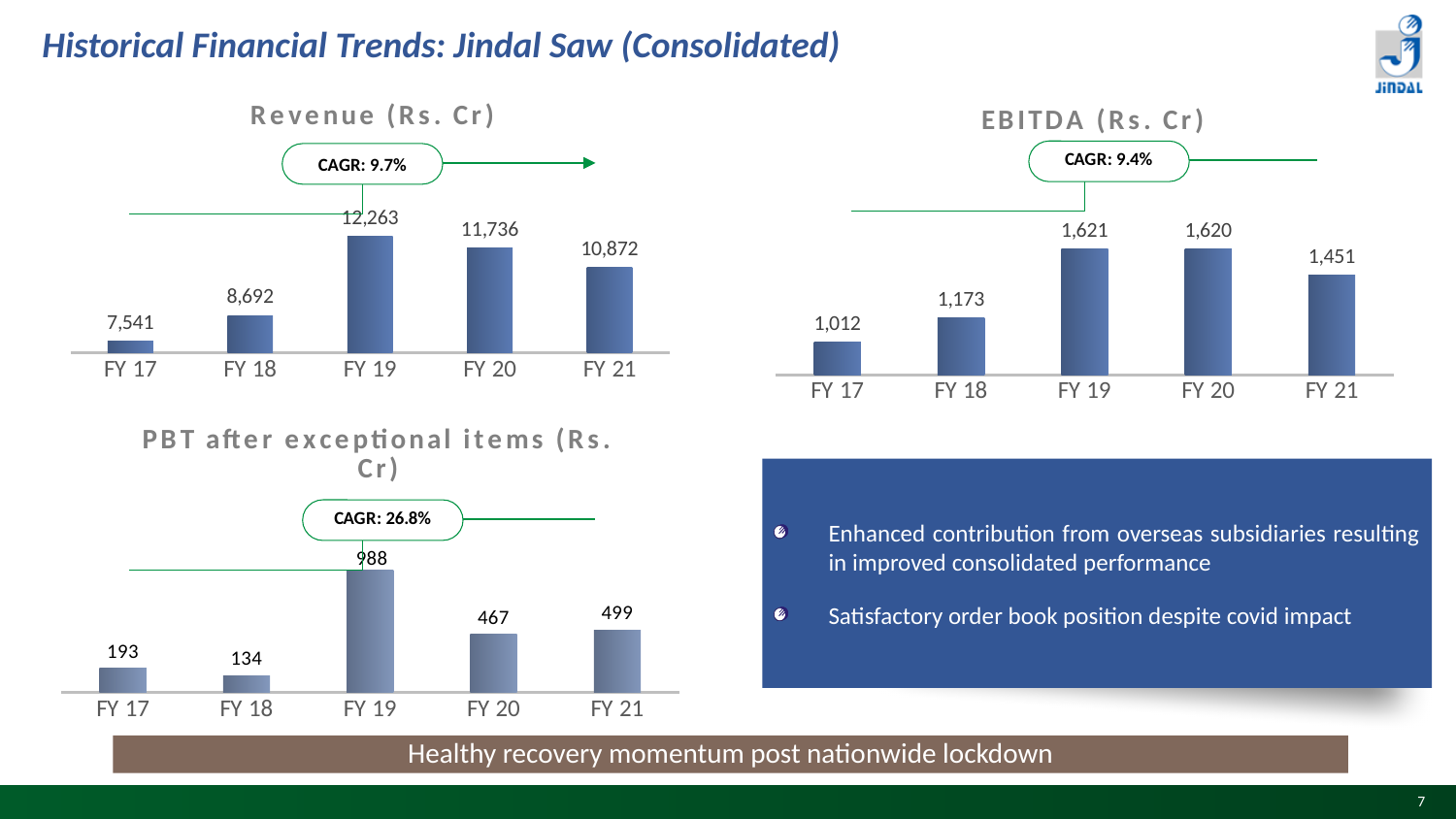
In the PBT after exceptional items (Rs. Cr) chart, what is the difference between the FY 21 and FY 20 values? 32 In the Revenue (Rs. Cr) chart, what is the value for FY 19? 12,263 In the PBT after exceptional items (Rs. Cr) chart, which fiscal year has the highest value? FY 19 In the EBITDA (Rs. Cr) chart, what is the value for FY 21? 1,451 How many fiscal years are shown in the Revenue (Rs. Cr) chart? 5 In the EBITDA (Rs. Cr) chart, which is larger, the value for FY 18 or the value for FY 21? FY 21 What CAGR is shown on the PBT after exceptional items (Rs. Cr) chart? 26.8% In the EBITDA (Rs. Cr) chart, what is the difference between the FY 18 and FY 17 values? 161 What type of chart is the EBITDA (Rs. Cr) chart? Bar chart In the Revenue (Rs. Cr) chart, which fiscal year has the lowest revenue? FY 17 In the PBT after exceptional items (Rs. Cr) chart, what is the value for FY 18? 134 In the Revenue (Rs. Cr) chart, what is the difference between the FY 20 and FY 21 values? 864